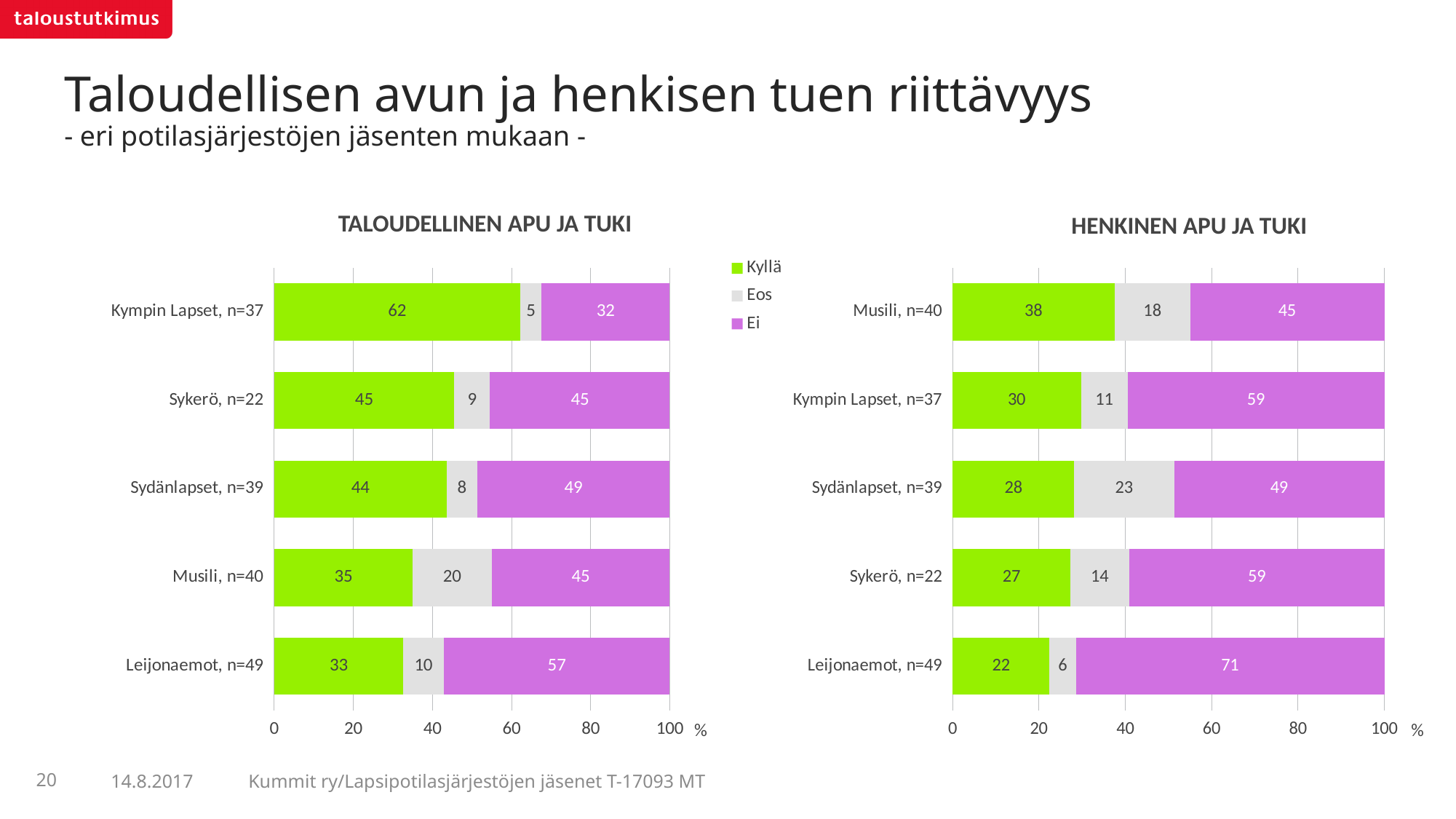
In the TALOUDELLINEN APU JA TUKI chart, what is the Eos value for Musili, n=40? 20 In the HENKINEN APU JA TUKI chart, what is the Ei value for Leijonaemot, n=49? 71 In the TALOUDELLINEN APU JA TUKI chart, which is larger: the Kyllä value for Sykerö, n=22 or the Kyllä value for Leijonaemot, n=49? Sykerö, n=22 What kind of chart is the TALOUDELLINEN APU JA TUKI chart? Stacked bar chart How many series does the legend list? 3 In the HENKINEN APU JA TUKI chart, which category has the highest Kyllä value? Musili, n=40 In the TALOUDELLINEN APU JA TUKI chart, which category has the lowest Eos value? Kympin Lapset, n=37 In the HENKINEN APU JA TUKI chart, what is the total of the stacked bar for Sydänlapset, n=39? 100 In the HENKINEN APU JA TUKI chart, what is the difference between the Ei value for Leijonaemot, n=49 and the Ei value for Musili, n=40? 26 In the TALOUDELLINEN APU JA TUKI chart, what is the Kyllä value for Kympin Lapset, n=37? 62 What are the three legend entries shown on the slide? Kyllä, Eos, Ei How many categories are shown in the HENKINEN APU JA TUKI chart? 5